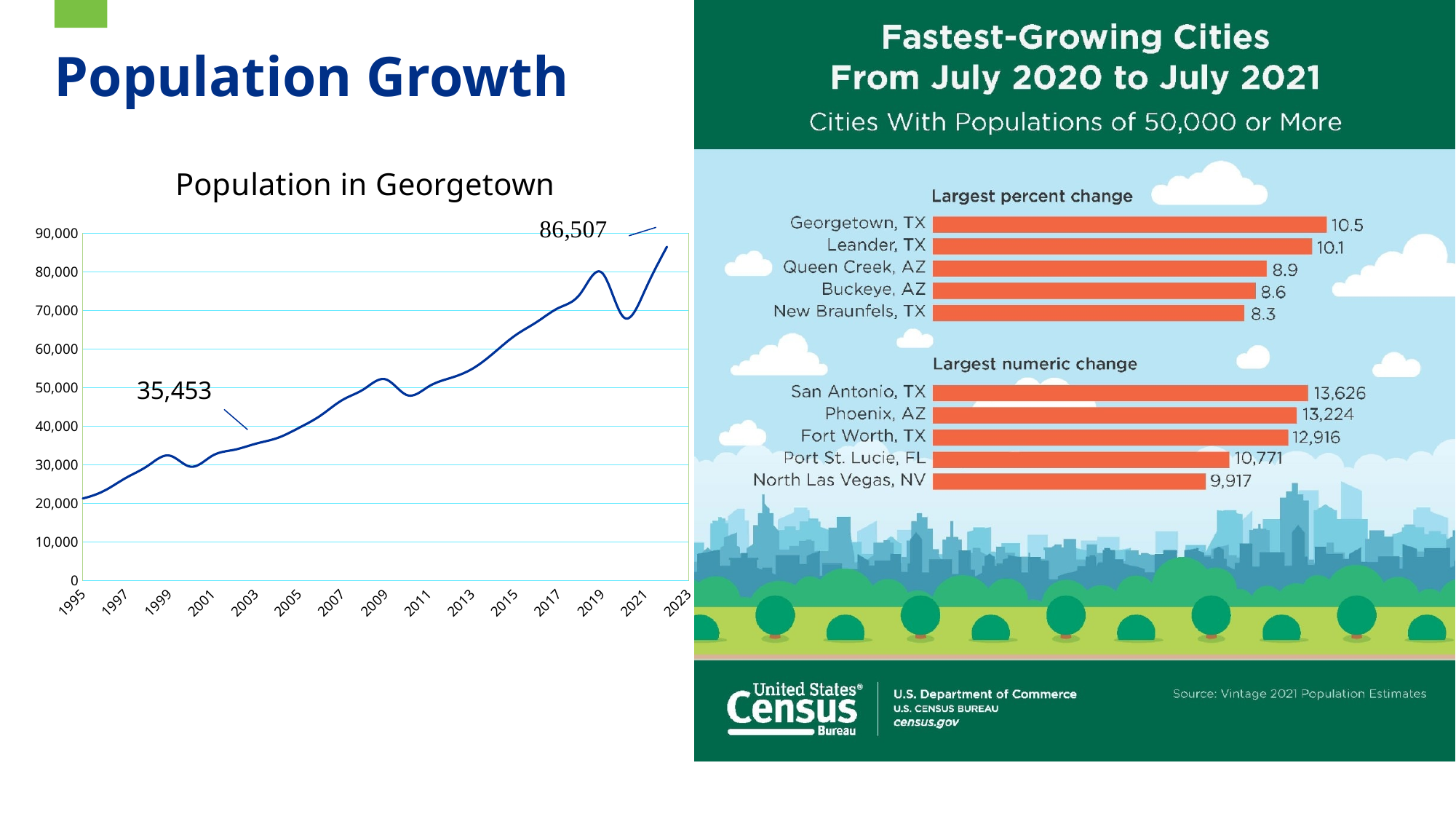
What type of chart is the 'Population in Georgetown' chart on the left of the slide? line chart In the 'Largest percent change' chart on the right, what is the difference between Georgetown, TX and Leander, TX? 0.4 In the 'Population in Georgetown' chart, is the value for 2019 greater or less than 70,000? greater In the 'Largest percent change' chart on the right, which city has the lowest value? New Braunfels, TX In the 'Largest numeric change' chart on the right, which city has the highest value? San Antonio, TX In the 'Largest numeric change' chart on the right, which is larger, Phoenix, AZ or Fort Worth, TX? Phoenix, AZ How many cities are listed in the 'Largest numeric change' chart on the right? 5 In the 'Population in Georgetown' chart, does the population generally rise or fall from 1995 to 2023? rise In the 'Largest percent change' chart on the right, what is the value for Georgetown, TX? 10.5 In the 'Population in Georgetown' chart, is the value for 1995 greater or less than 30,000? less In the 'Largest numeric change' chart on the right, what is the value for Port St. Lucie, FL? 10,771 In the 'Population in Georgetown' chart, what is the data label shown near the end of the line at the top right? 86,507